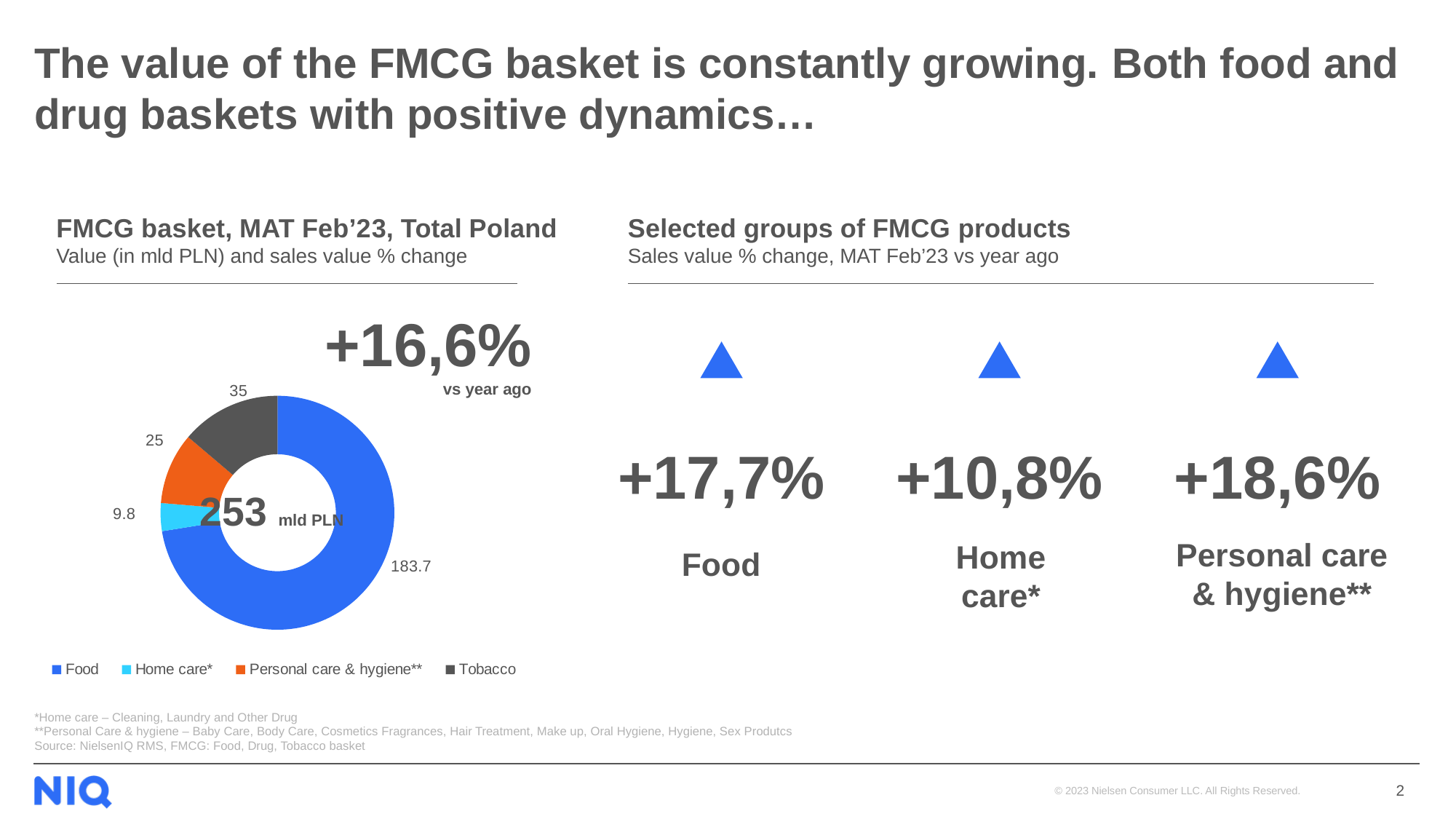
What sales value % change vs year ago is shown next to the FMCG basket donut chart? +16,6% In the FMCG basket donut chart, which category has the largest value? Food What type of chart is used in the 'FMCG basket, MAT Feb'23, Total Poland' chart? Donut (pie) chart In the FMCG basket donut chart, what is the value for Personal care & hygiene**? 25 In the FMCG basket donut chart, what is the value for Tobacco? 35 In the FMCG basket donut chart, which category has the smallest value? Home care* What total value is shown in the centre of the FMCG basket donut chart? 253 mld PLN In the FMCG basket donut chart, what is the difference between the Tobacco value and the Personal care & hygiene** value? 10 How many categories does the FMCG basket donut chart show? 4 In the FMCG basket donut chart, what is the value for Food? 183.7 In the FMCG basket donut chart, what is the value for Home care*? 9.8 In the FMCG basket donut chart, which is larger: Tobacco or Personal care & hygiene**? Tobacco